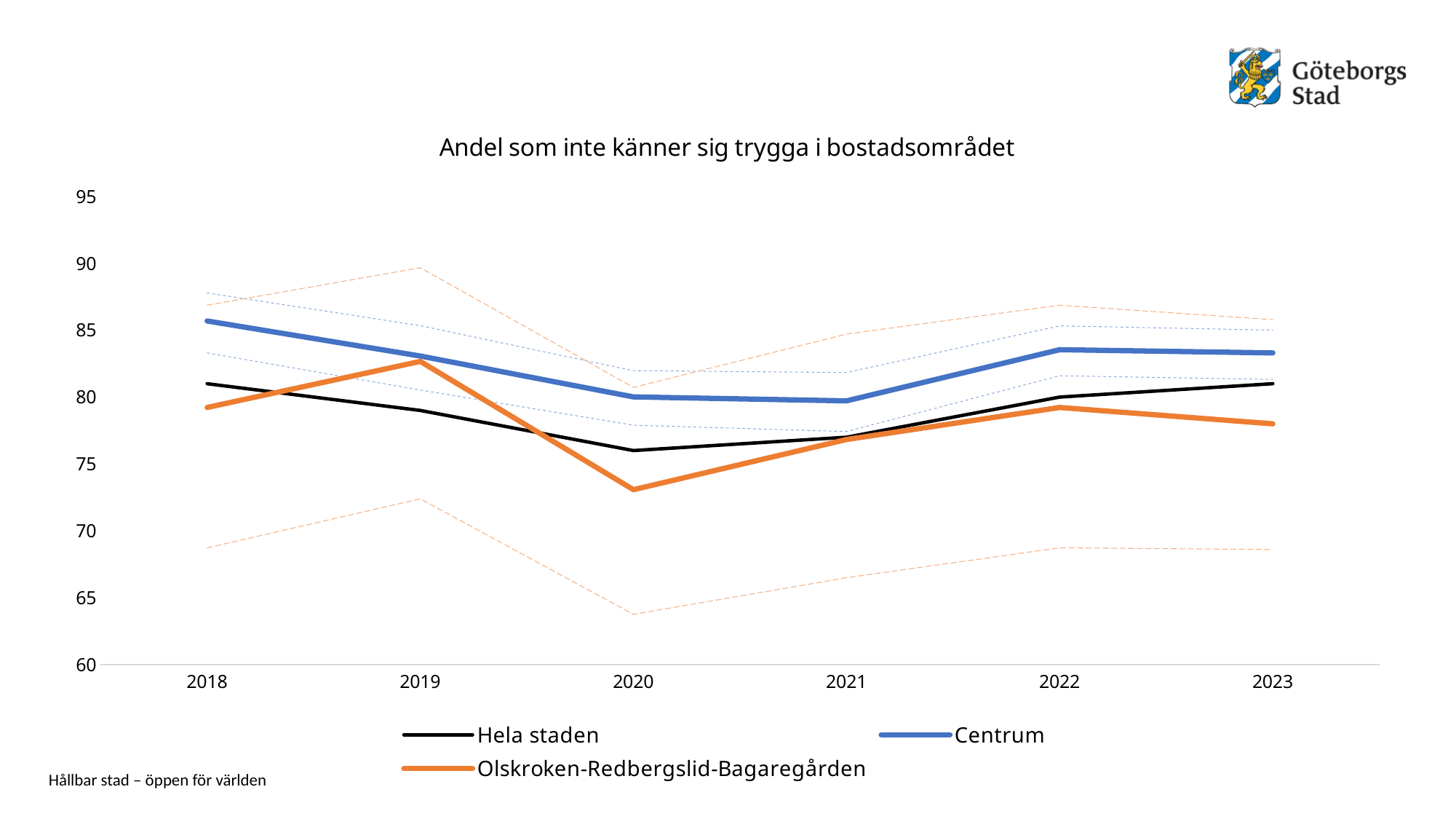
In 2018, which is larger: Centrum or Olskroken-Redbergslid-Bagaregården? Centrum Is the value for Olskroken-Redbergslid-Bagaregården in 2019 greater or less than 80? greater Is the value for Centrum in 2022 greater or less than 80? greater Is the value for Olskroken-Redbergslid-Bagaregården in 2020 greater or less than 75? less How many series does the legend list? 3 In which year is the Olskroken-Redbergslid-Bagaregården line at its lowest? 2020 How many years are shown on the x axis? 6 What is the title of the chart? Andel som inte känner sig trygga i bostadsområdet In which year is the Centrum line at its highest? 2018 What kind of chart is shown on the slide? line chart Does the Centrum line rise or fall from 2018 to 2020? fall